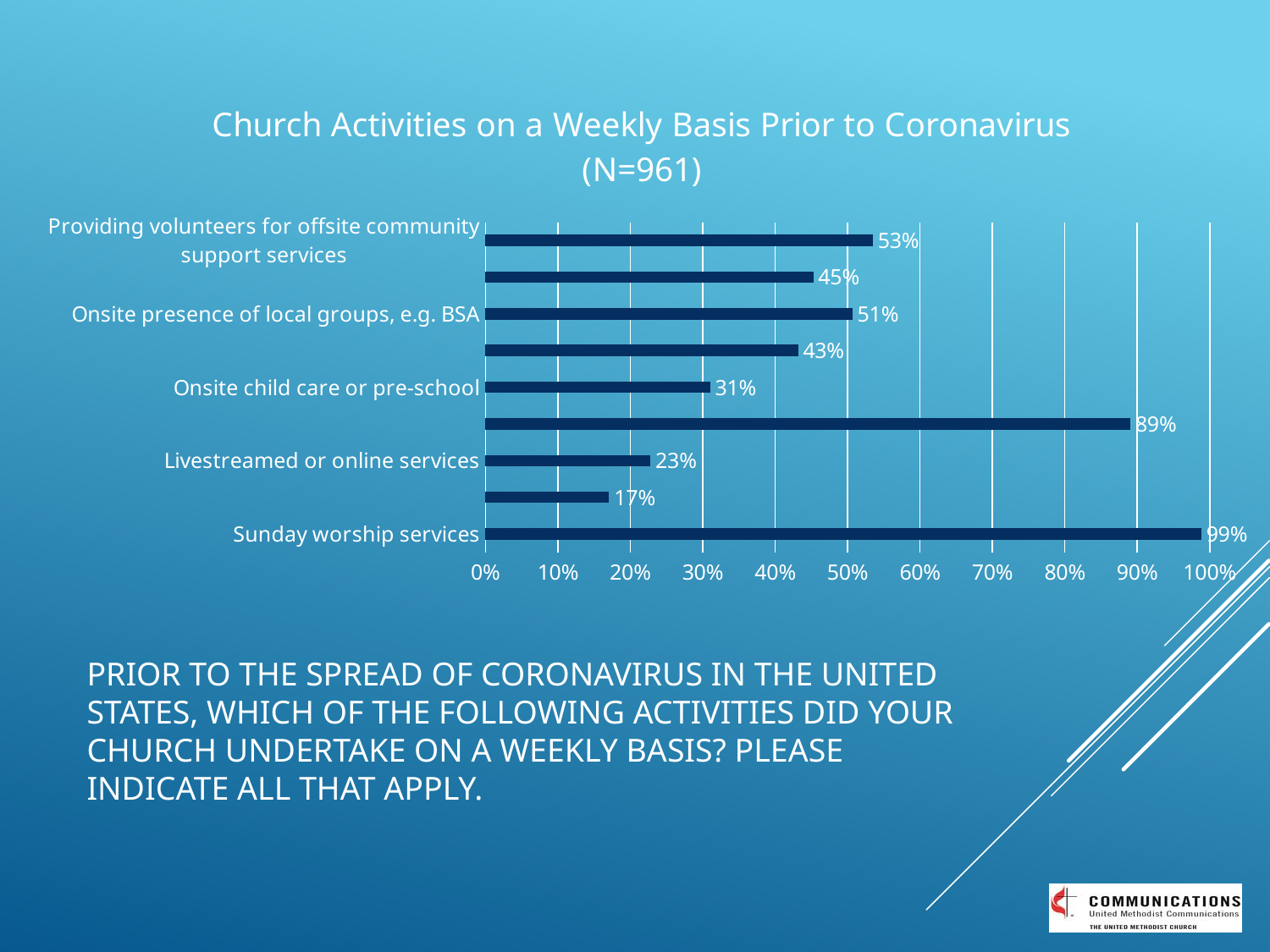
Which is larger: the value for Onsite presence of local groups, e.g. BSA or the value for Onsite child care or pre-school? Onsite presence of local groups, e.g. BSA What kind of chart is shown on the slide? bar chart What is the lowest value shown on any bar in the chart? 17% What is the difference in percentage points between Sunday worship services and Livestreamed or online services? 76 percentage points What percentage of churches held Sunday worship services on a weekly basis? 99% What is the value for Providing volunteers for offsite community support services? 53% How many bars are plotted in the chart? 9 What is the value for Onsite presence of local groups, e.g. BSA? 51% What is the value for Livestreamed or online services? 23% What is the title of the chart? Church Activities on a Weekly Basis Prior to Coronavirus (N=961) Which activity has the highest value in the chart? Sunday worship services What is the value for Onsite child care or pre-school? 31%